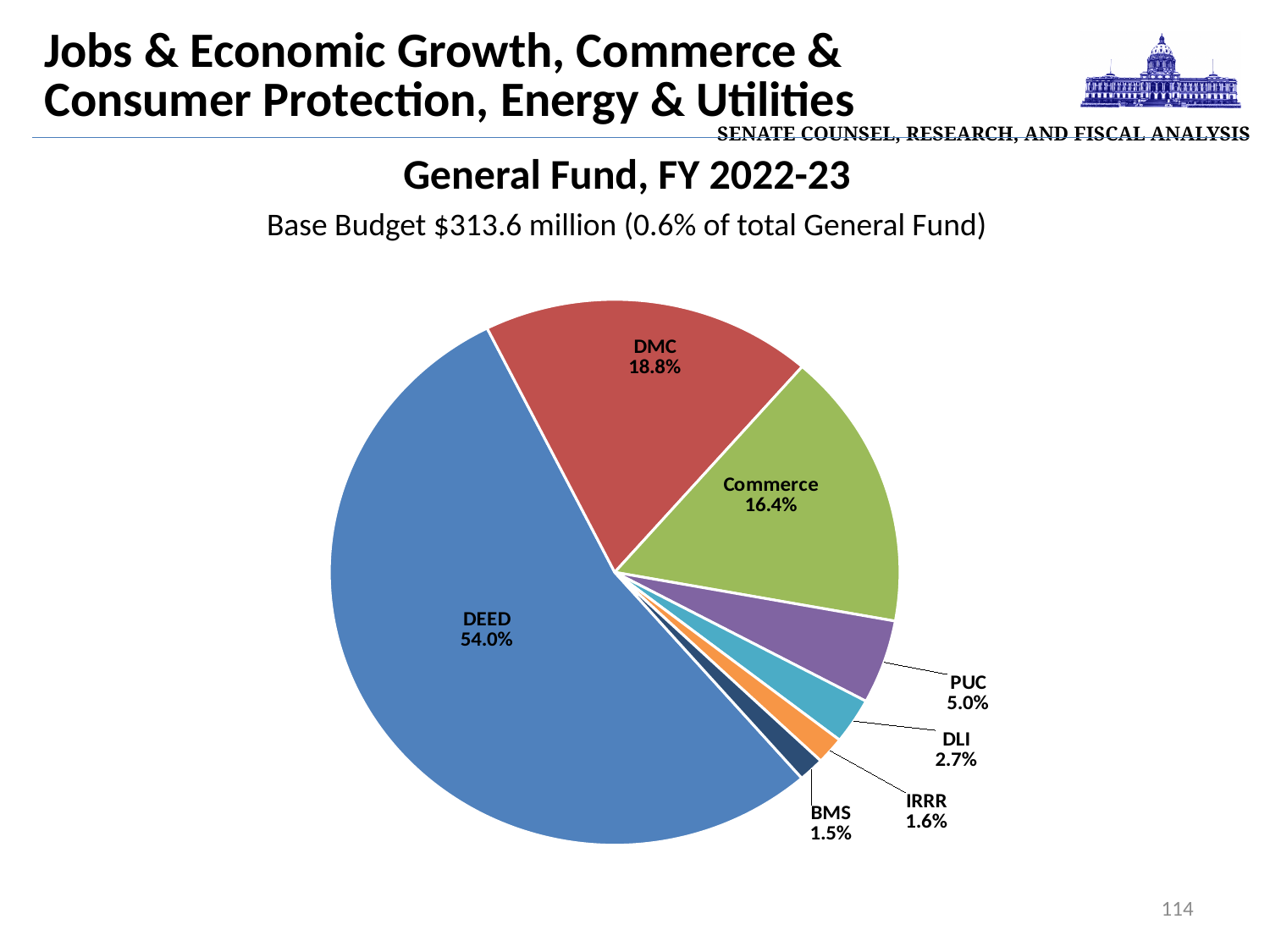
What kind of chart is shown on the slide? pie chart How many slices does the pie chart have? 7 Which slice of the pie is the smallest? BMS What percentage is shown for Commerce? 16.4% What percentage is shown for PUC? 5.0% What is the title of the chart? General Fund, FY 2022-23 What share of the General Fund, FY 2022-23 pie does DEED hold? 54.0% What percentage is shown for DMC? 18.8% What is the combined percentage of DMC and Commerce? 35.2% Which slice of the pie is the largest? DEED Which is larger, the DLI slice or the PUC slice? PUC What is the difference in percentage points between DMC and Commerce? 2.4